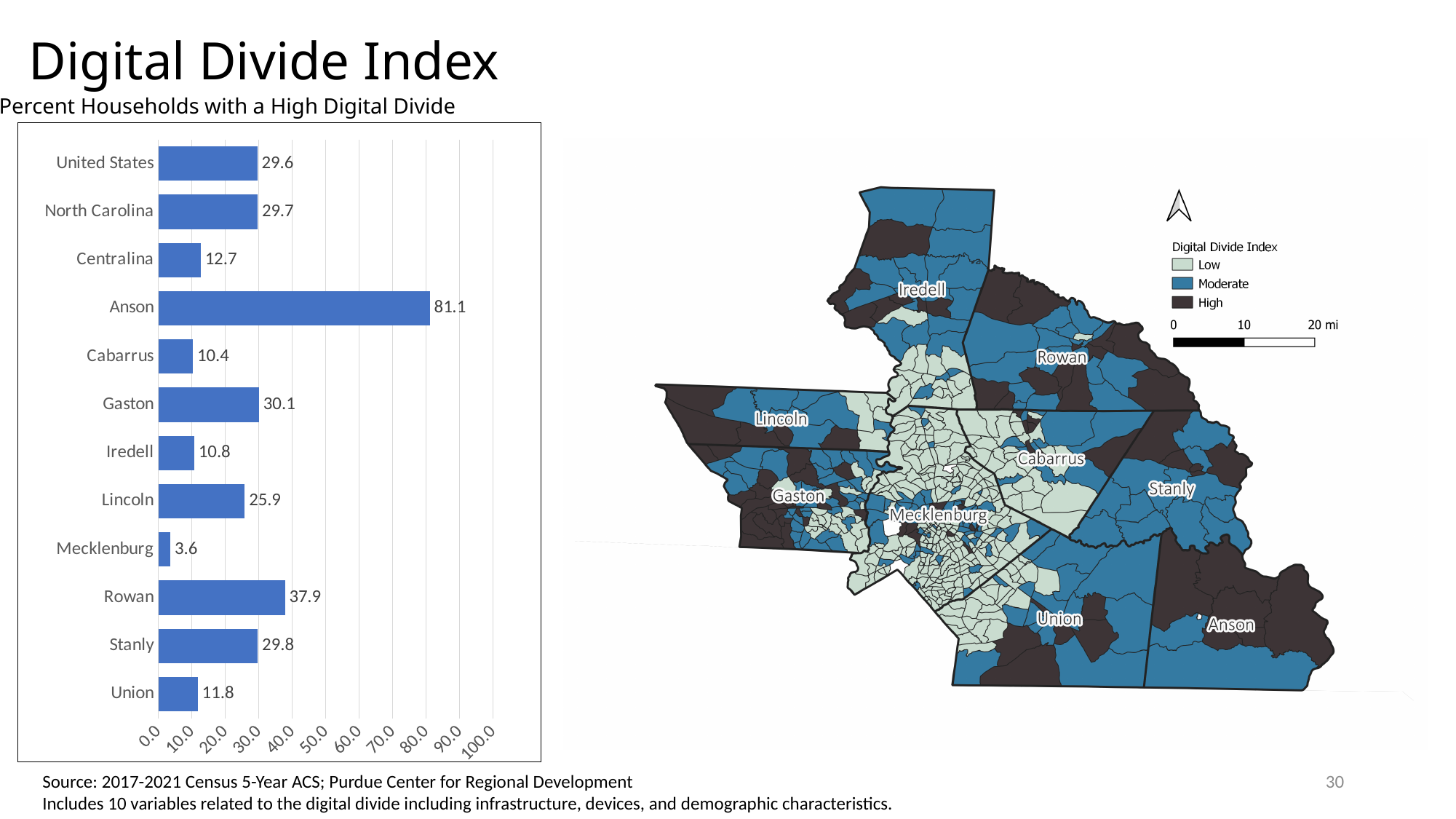
Which category has the lowest value in the bar chart? Mecklenburg What is the value for North Carolina in the bar chart? 29.7 What is the difference between the values for Rowan and Union in the bar chart? 26.1 What is the value for Mecklenburg in the bar chart? 3.6 What kind of chart is shown on the left of the slide? bar chart What is the title of the bar chart? Percent Households with a High Digital Divide Is the value for Rowan in the bar chart greater or less than 30.0? greater Which category has the highest value in the bar chart? Anson How many categories are shown in the bar chart? 12 What is the value for Anson in the bar chart? 81.1 What is the difference between the values for Anson and Centralina in the bar chart? 68.4 Which is larger in the bar chart, the value for Gaston or the value for Lincoln? Gaston